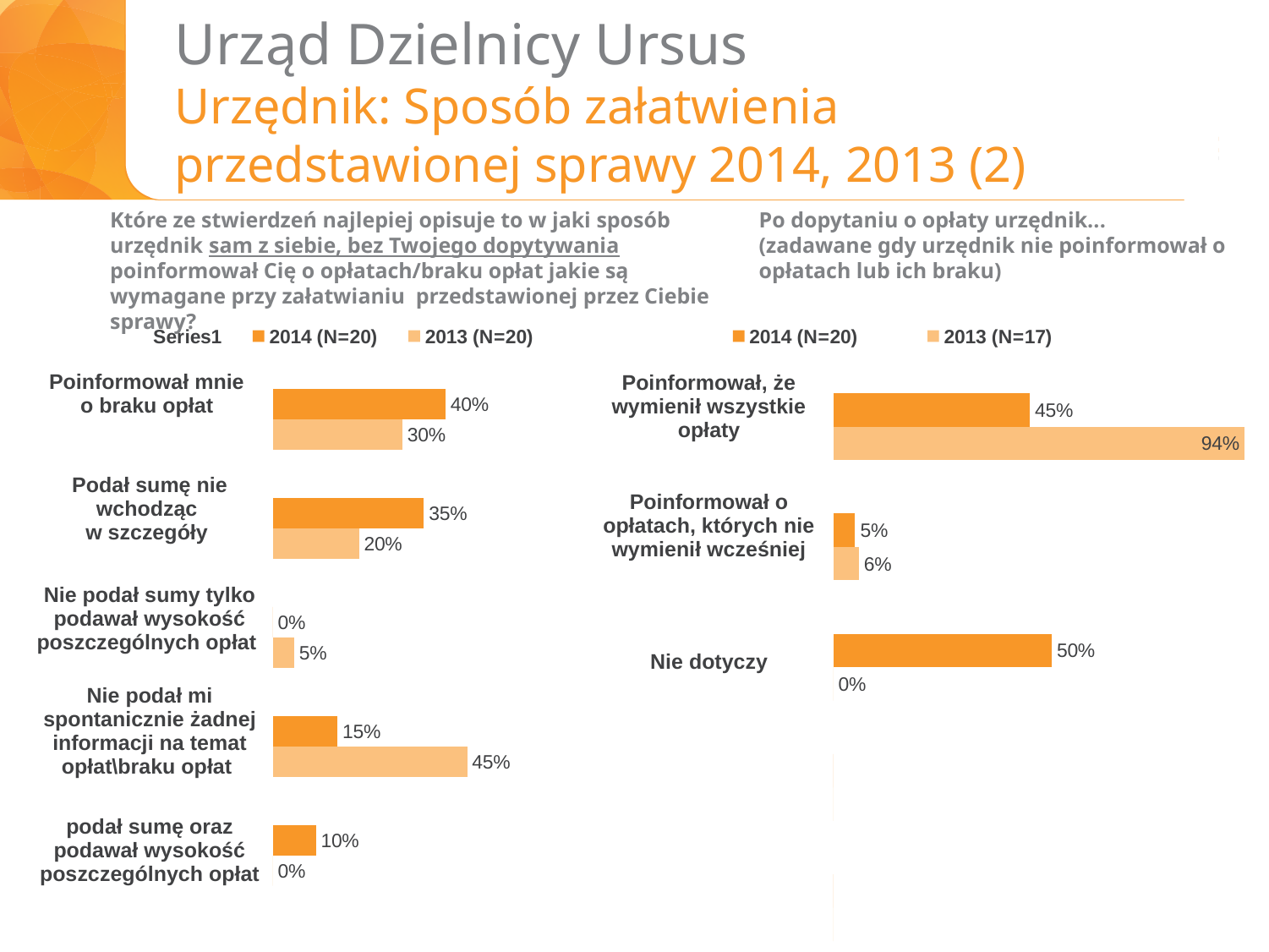
In the right chart, which category has the lowest 2014 (N=20) value? Poinformował o opłatach, których nie wymienił wcześniej How many categories are shown in the left chart? 5 In the left chart, what is the 2014 (N=20) value for 'Poinformował mnie o braku opłat'? 40% In the left chart, what is the 2013 (N=20) value for 'Nie podał mi spontanicznie żadnej informacji na temat opłat\braku opłat'? 45% In the right chart, what is the difference between the 2013 (N=17) and 2014 (N=20) values for 'Poinformował, że wymienił wszystkie opłaty'? 49 percentage points In the right chart, what is the 2014 (N=20) value for 'Nie dotyczy'? 50% In the left chart, which category has the highest 2014 (N=20) value? Poinformował mnie o braku opłat In the left chart, what is the difference between the 2014 and 2013 values for 'Podał sumę nie wchodząc w szczegóły'? 15 percentage points In the right chart, what is the 2013 (N=17) value for 'Poinformował, że wymienił wszystkie opłaty'? 94% What type of chart is the right chart? Bar chart In the left chart, which is larger for 'Nie podał mi spontanicznie żadnej informacji na temat opłat\braku opłat': the 2014 value or the 2013 value? 2013 How many series does the legend of the right chart list? 2